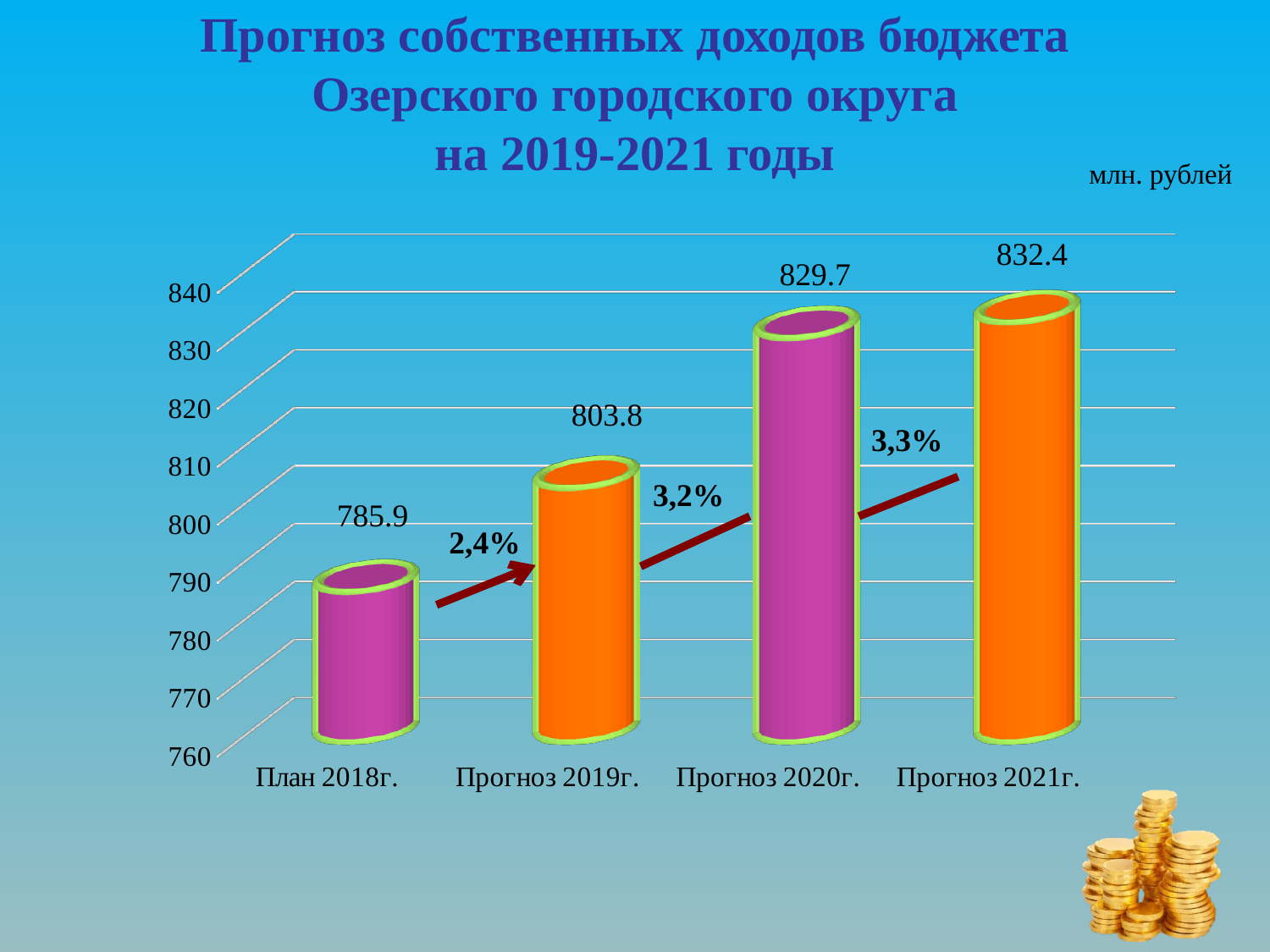
What is the value for План 2018г.? 785.9 What kind of chart is shown on the slide? Bar chart What is the value for Прогноз 2019г.? 803.8 What unit of measurement is indicated for the chart values? млн. рублей What is the difference between the values for Прогноз 2020г. and Прогноз 2019г.? 25.9 Which category has the lowest value? План 2018г. Which category has the highest value? Прогноз 2021г. How many categories are shown on the x axis? 4 Do the values rise or fall from План 2018г. to Прогноз 2021г.? Rise What is the value for Прогноз 2021г.? 832.4 Which is larger, the value for Прогноз 2019г. or the value for План 2018г.? Прогноз 2019г. What is the value for Прогноз 2020г.? 829.7